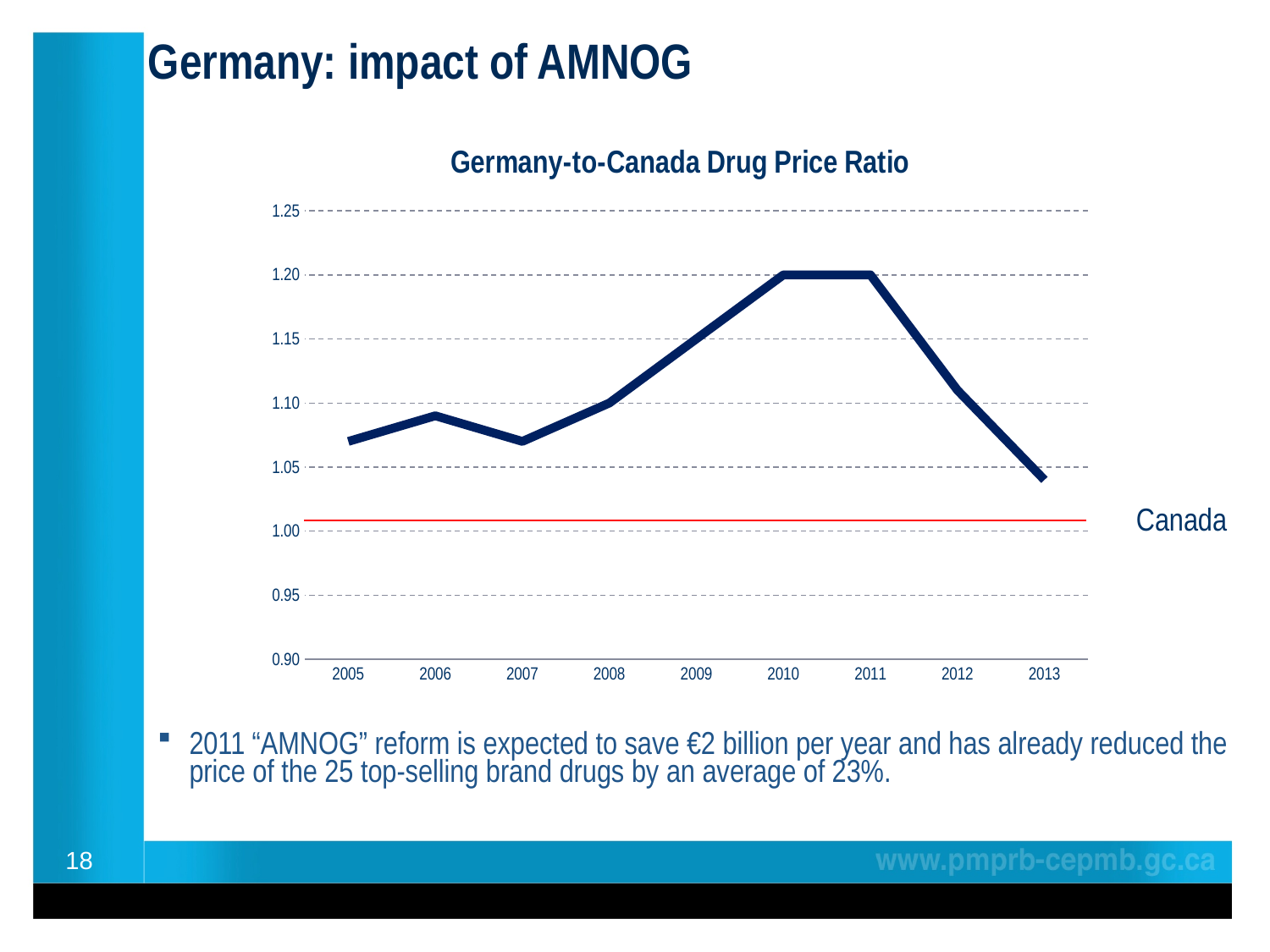
Which year has the larger ratio, 2010 or 2013? 2010 How many years are plotted along the x axis of the chart? 9 What is the Germany-to-Canada drug price ratio in 2010? 1.20 What is the highest value reached by the line on the chart? 1.20 Does the ratio rise or fall from 2011 to 2013? fall Is the value for 2012 greater or less than 1.15? less What kind of chart is shown on the slide? line chart Is the value for 2009 greater or less than 1.10? greater What label is given to the red horizontal reference line on the chart? Canada Is the value for 2013 greater or less than 1.05? less What is the title of the chart? Germany-to-Canada Drug Price Ratio Which year has the lowest Germany-to-Canada drug price ratio? 2013